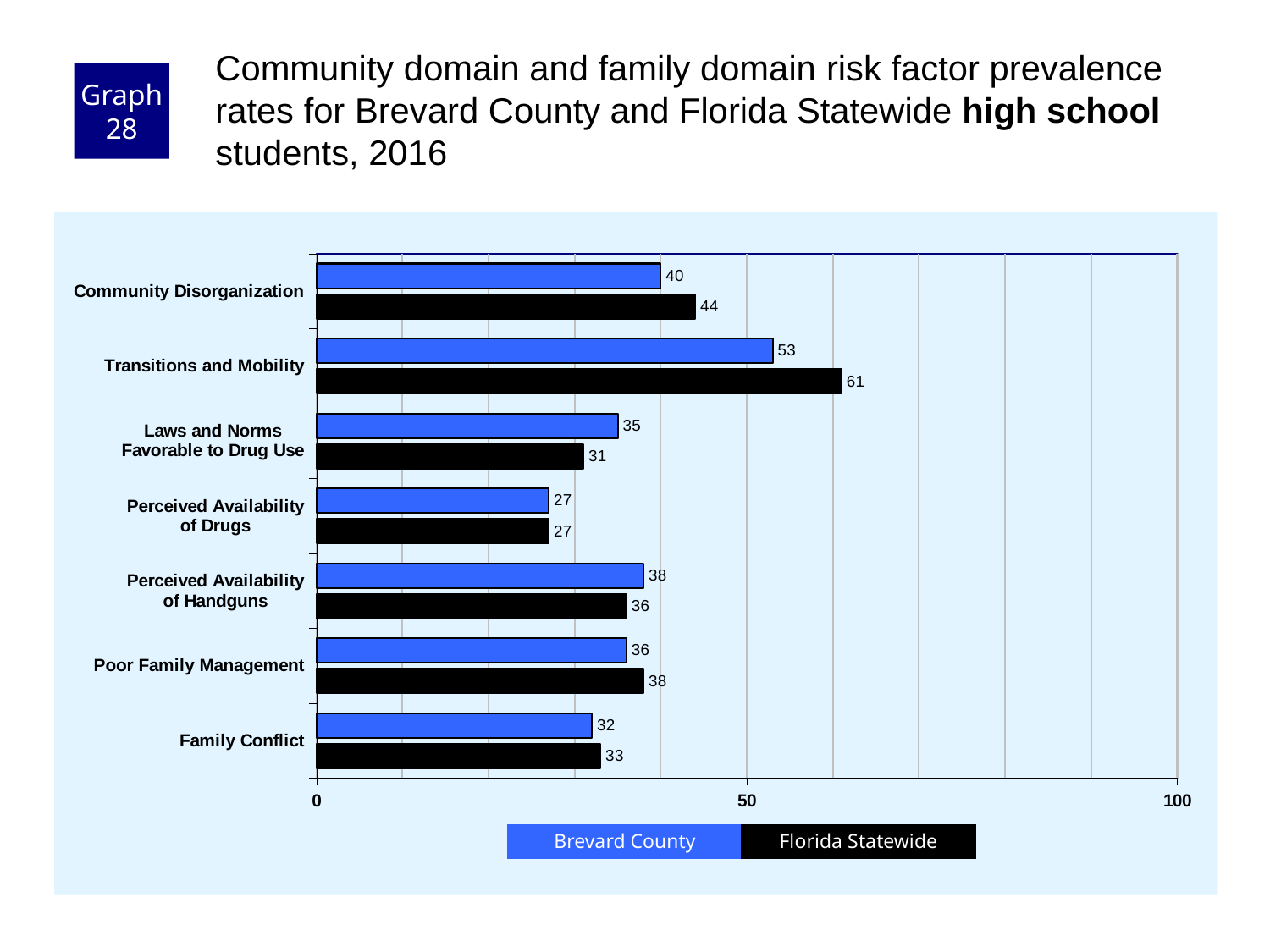
How many risk factor categories are shown on the chart? 7 Which risk factor has the lowest Brevard County value? Perceived Availability of Drugs What is the Brevard County value for Transitions and Mobility? 53 What is the difference between the Florida Statewide and Brevard County values for Transitions and Mobility? 8 For Perceived Availability of Handguns, which is larger: the Brevard County value or the Florida Statewide value? Brevard County What is the Florida Statewide value for Laws and Norms Favorable to Drug Use? 31 Which colour represents Florida Statewide in the chart? black What kind of chart is shown on the slide? bar chart Is the Florida Statewide value for Transitions and Mobility greater or less than 50? greater How many series does the legend list? 2 What is the Florida Statewide value for Community Disorganization? 44 Which risk factor has the highest Florida Statewide value? Transitions and Mobility